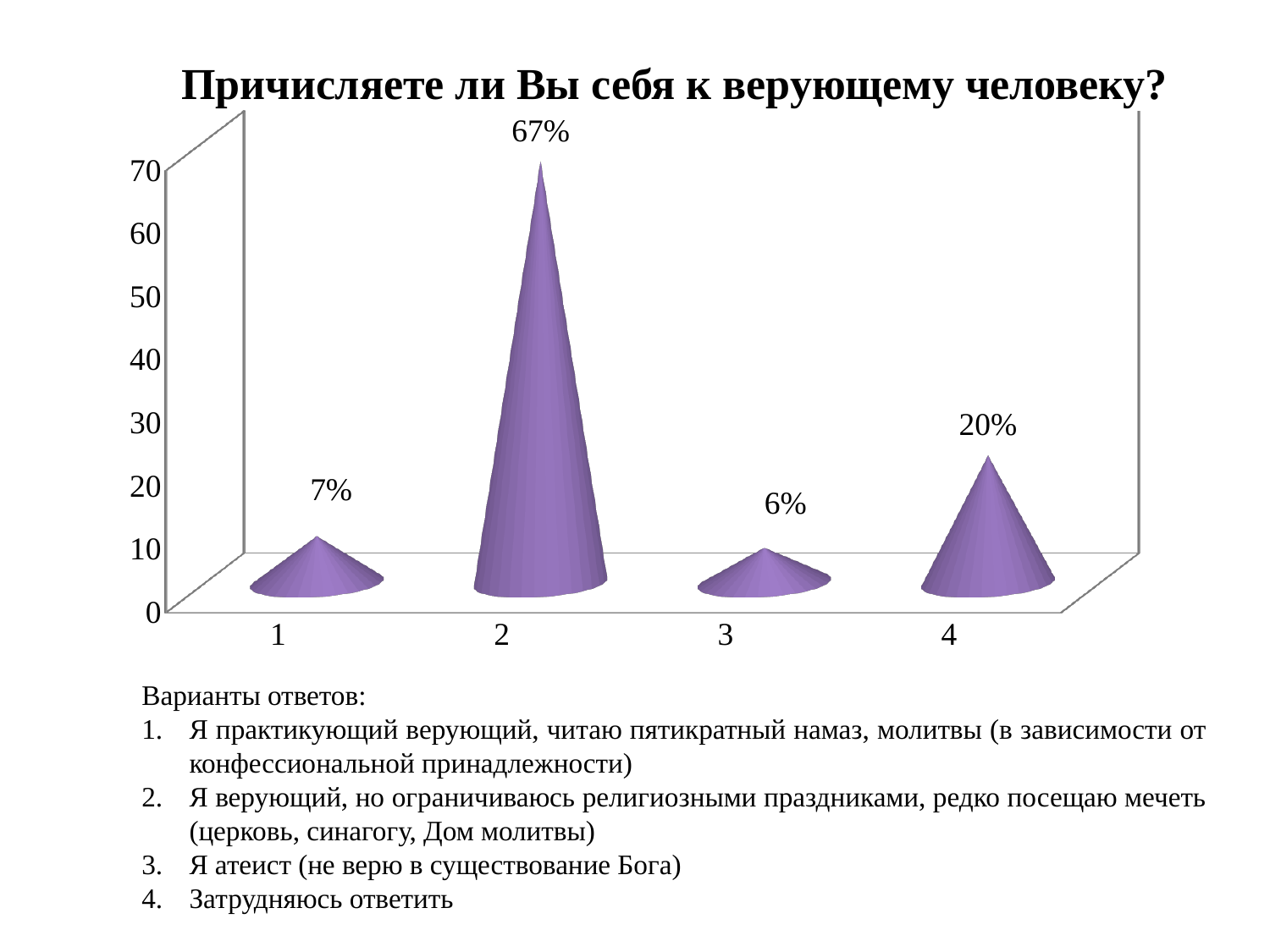
Which category has the lowest value? 3 What is the difference between the values for category 2 and category 4? 47 percentage points What value is shown for category 2? 67% What kind of chart is shown on the slide? Bar chart (3D cone-shaped bars) What value is shown for category 1? 7% What value is shown for category 4? 20% Which is larger, the value for category 1 or the value for category 3? Category 1 What value is shown for category 3? 6% Which category has the highest value? 2 How many categories are shown on the x axis? 4 What is the title of the chart? Причисляете ли Вы себя к верующему человеку? Is the value for category 4 greater or less than 10? greater